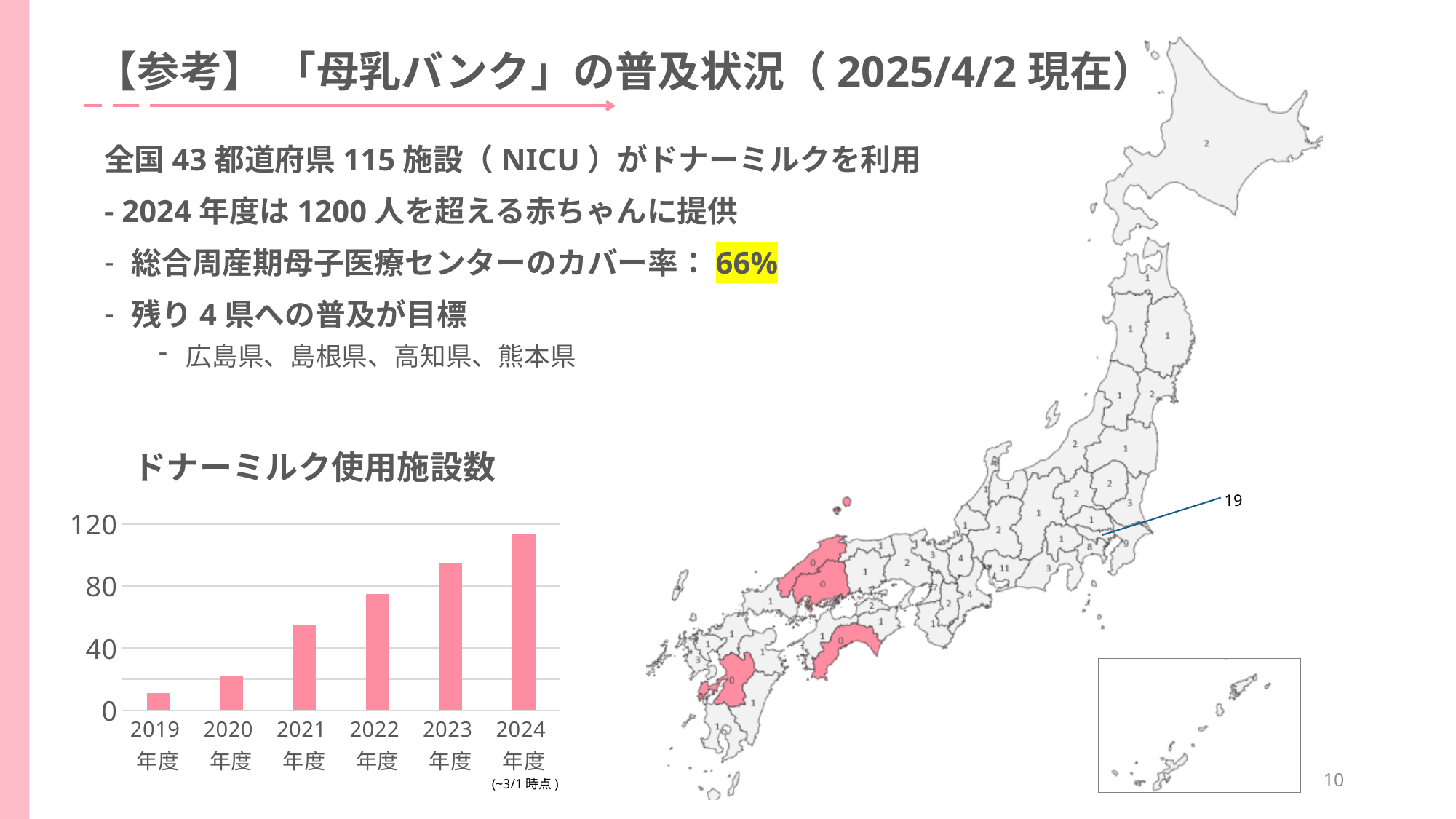
Which fiscal year has the lowest value in the 'ドナーミルク使用施設数' chart? 2019年度 In the 'ドナーミルク使用施設数' chart, is the value for 2019年度 greater or less than 40? less In the 'ドナーミルク使用施設数' chart, is the value for 2024年度 greater or less than 120? less What is the highest tick value shown on the y axis of the 'ドナーミルク使用施設数' chart? 120 In the 'ドナーミルク使用施設数' chart, which is larger, the value for 2020年度 or the value for 2022年度? 2022年度 In the 'ドナーミルク使用施設数' chart, is the value for 2021年度 greater or less than 40? greater What kind of chart is 'ドナーミルク使用施設数'? bar chart How many fiscal years are shown on the x axis of the 'ドナーミルク使用施設数' chart? 6 Which fiscal year has the highest value in the 'ドナーミルク使用施設数' chart? 2024年度 In the 'ドナーミルク使用施設数' chart, do the values rise or fall from 2019年度 to 2024年度? rise What is the title of the bar chart on the slide? ドナーミルク使用施設数